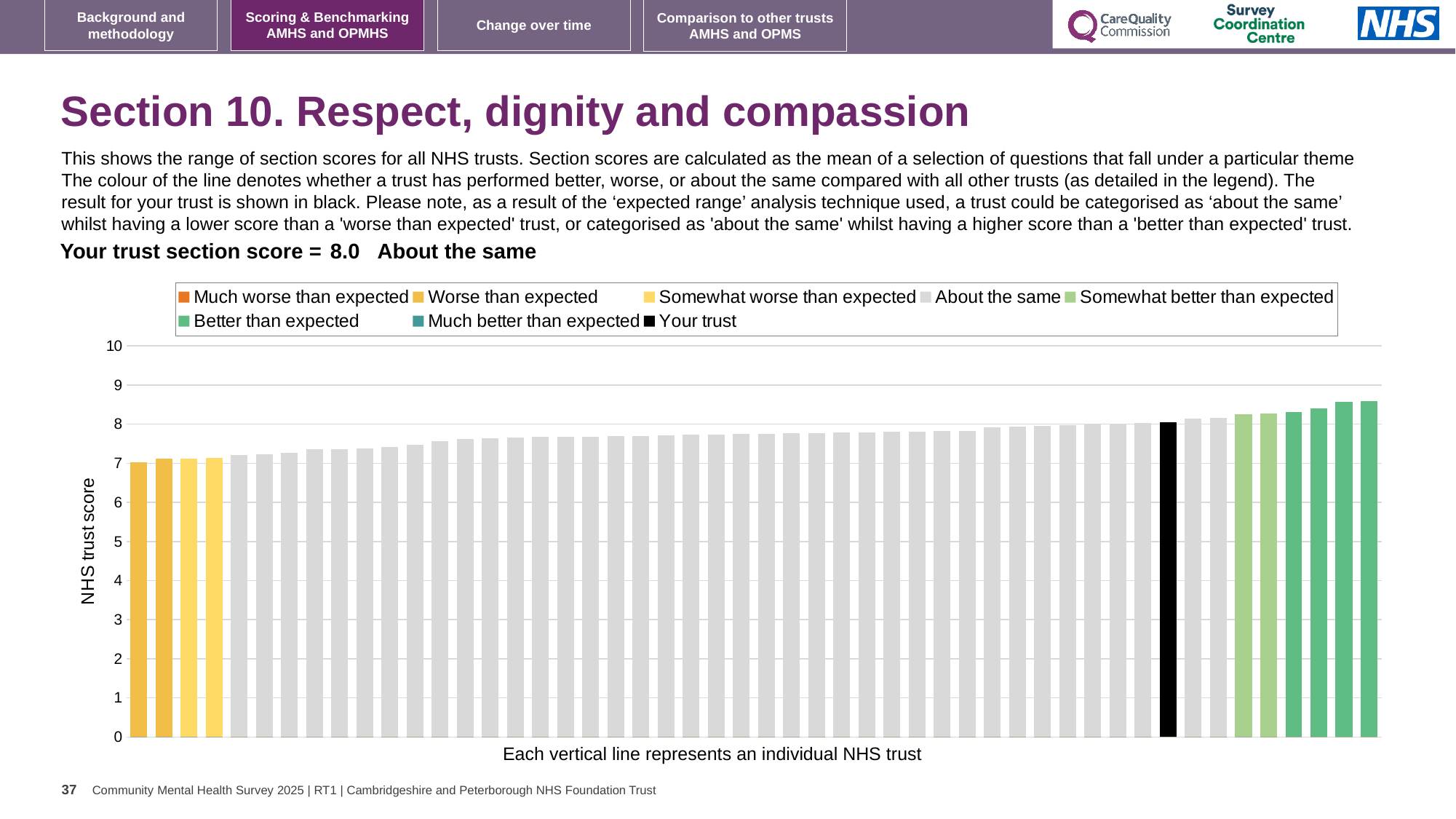
Which category does your trust fall into for this section? About the same Do the bar values rise or fall from left to right across the chart? rise Is the value for your trust (the black bar) greater or less than 7? greater What is the section score for your trust shown on the slide? 8.0 Is the value of the rightmost (highest) bar greater or less than 9? less How many entries does the chart legend list? 8 How many bars on the chart are black? 1 What does each vertical line on the chart represent, according to the x-axis label? an individual NHS trust Is the value of the rightmost (highest) bar greater or less than 8? greater What is the label on the vertical axis of the chart? NHS trust score What kind of chart is shown on the slide? bar chart